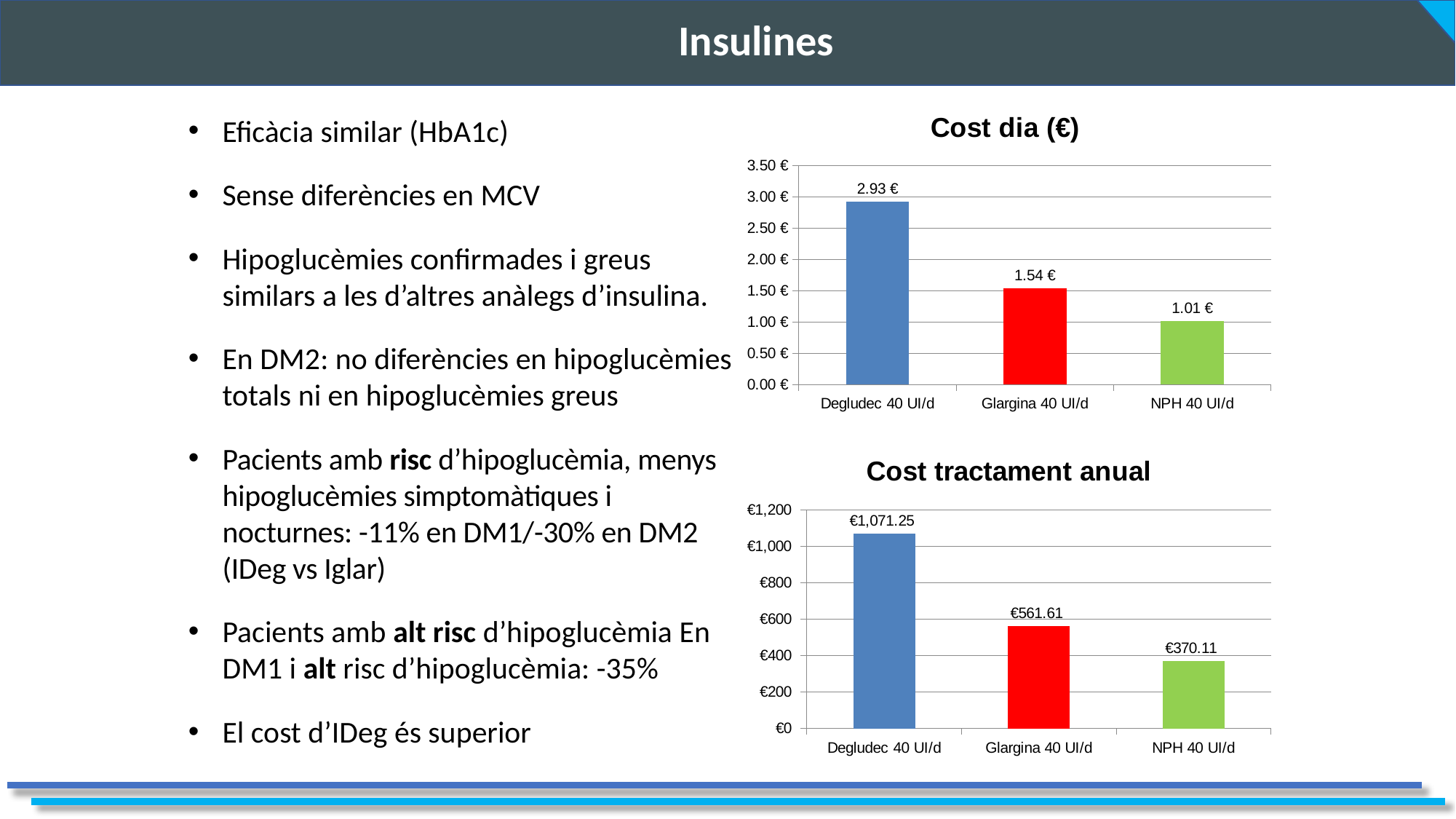
In the 'Cost dia (€)' chart, what is the value for Degludec 40 UI/d? 2.93 € In the 'Cost dia (€)' chart, what is the difference between Degludec 40 UI/d and Glargina 40 UI/d? 1.39 € In the 'Cost tractament anual' chart, what is the value for Glargina 40 UI/d? €561.61 In the 'Cost tractament anual' chart, what is the value for Degludec 40 UI/d? €1,071.25 In the 'Cost tractament anual' chart, what colour is the bar for NPH 40 UI/d? Green What kind of chart is the 'Cost dia (€)' chart? Bar chart In the 'Cost dia (€)' chart, how many categories are shown? 3 In the 'Cost tractament anual' chart, which category has the highest value? Degludec 40 UI/d In the 'Cost dia (€)' chart, what is the value for NPH 40 UI/d? 1.01 € In the 'Cost dia (€)' chart, which category has the lowest value? NPH 40 UI/d In the 'Cost tractament anual' chart, do the values rise or fall from left to right? Fall In the 'Cost tractament anual' chart, which is larger: Glargina 40 UI/d or NPH 40 UI/d? Glargina 40 UI/d